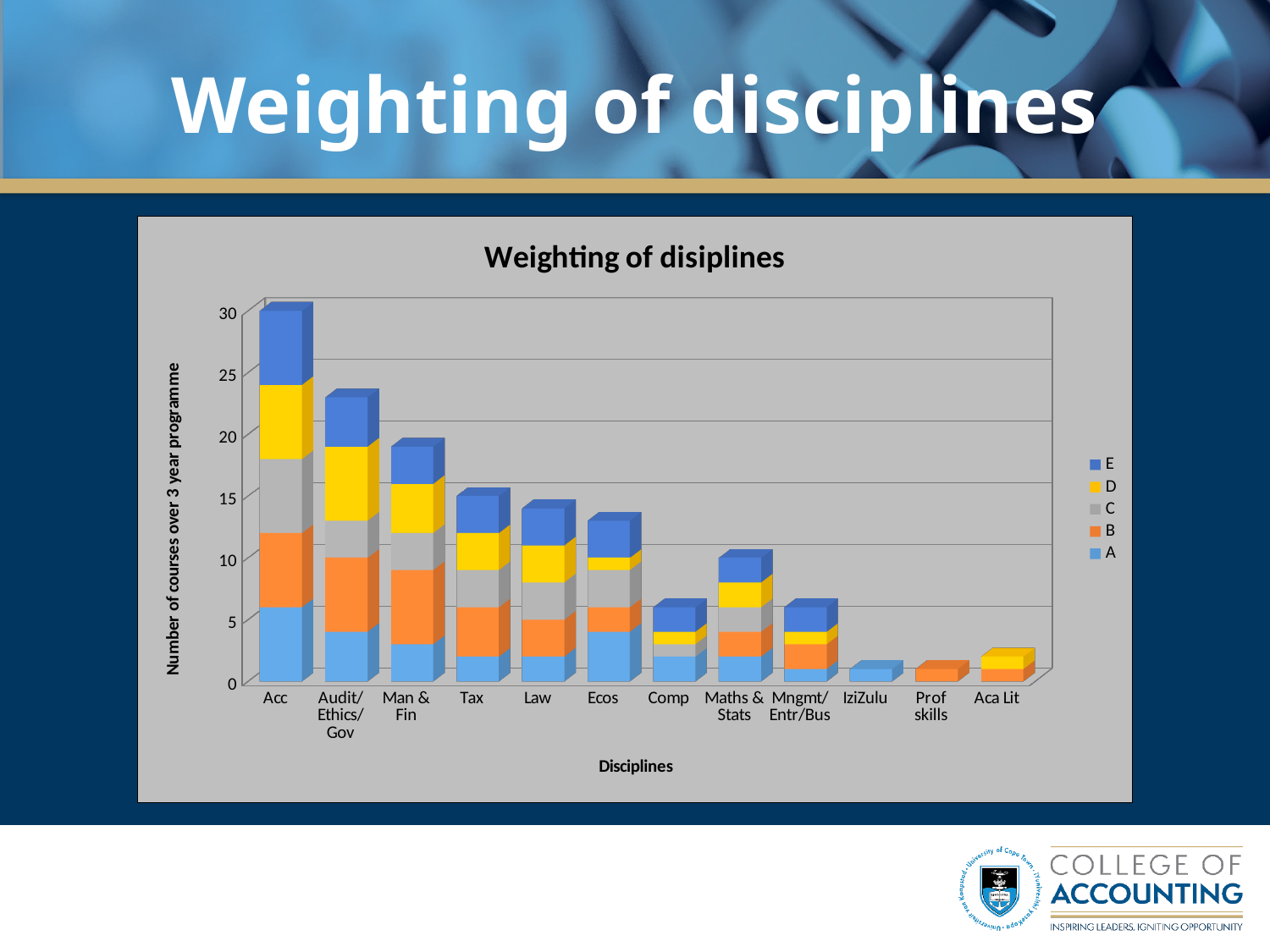
Do the bar totals generally rise or fall moving from left to right along the x axis? fall Is the total value for Audit/Ethics/Gov greater or less than 20? greater Is the total value for Ecos greater or less than 10? greater Which discipline has the tallest stacked bar? Acc Is the total value for Acc greater or less than 25? greater Which has the larger total, Acc or Tax? Acc What kind of chart is shown on the slide? Stacked bar chart How many disciplines are plotted along the x axis? 12 What is the label on the vertical axis of the chart? Number of courses over 3 year programme How many series does the legend list? 5